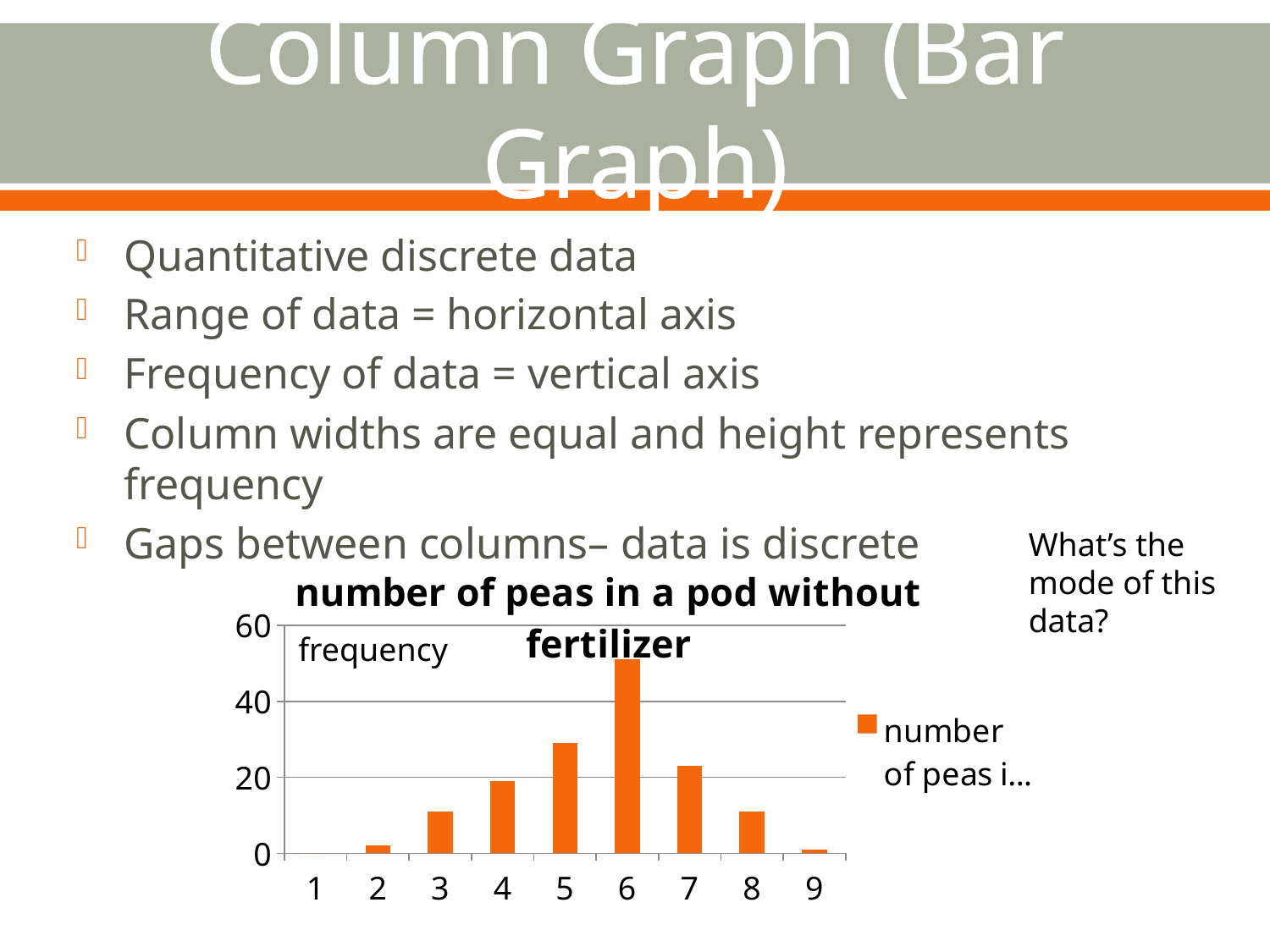
What kind of chart is shown on the slide? bar chart Do the values rise or fall from category 1 to category 6? rise What is the title of the chart? number of peas in a pod without fertilizer Is the value for 6 greater or less than 40? greater Is the value for 5 greater or less than 20? greater How many series does the legend list? 1 Which has the larger value, 5 or 7? 5 Is the value for 8 greater or less than 20? less Which category on the x axis has the highest bar? 6 Which has the larger value, 4 or 8? 4 How many categories are shown on the x axis? 9